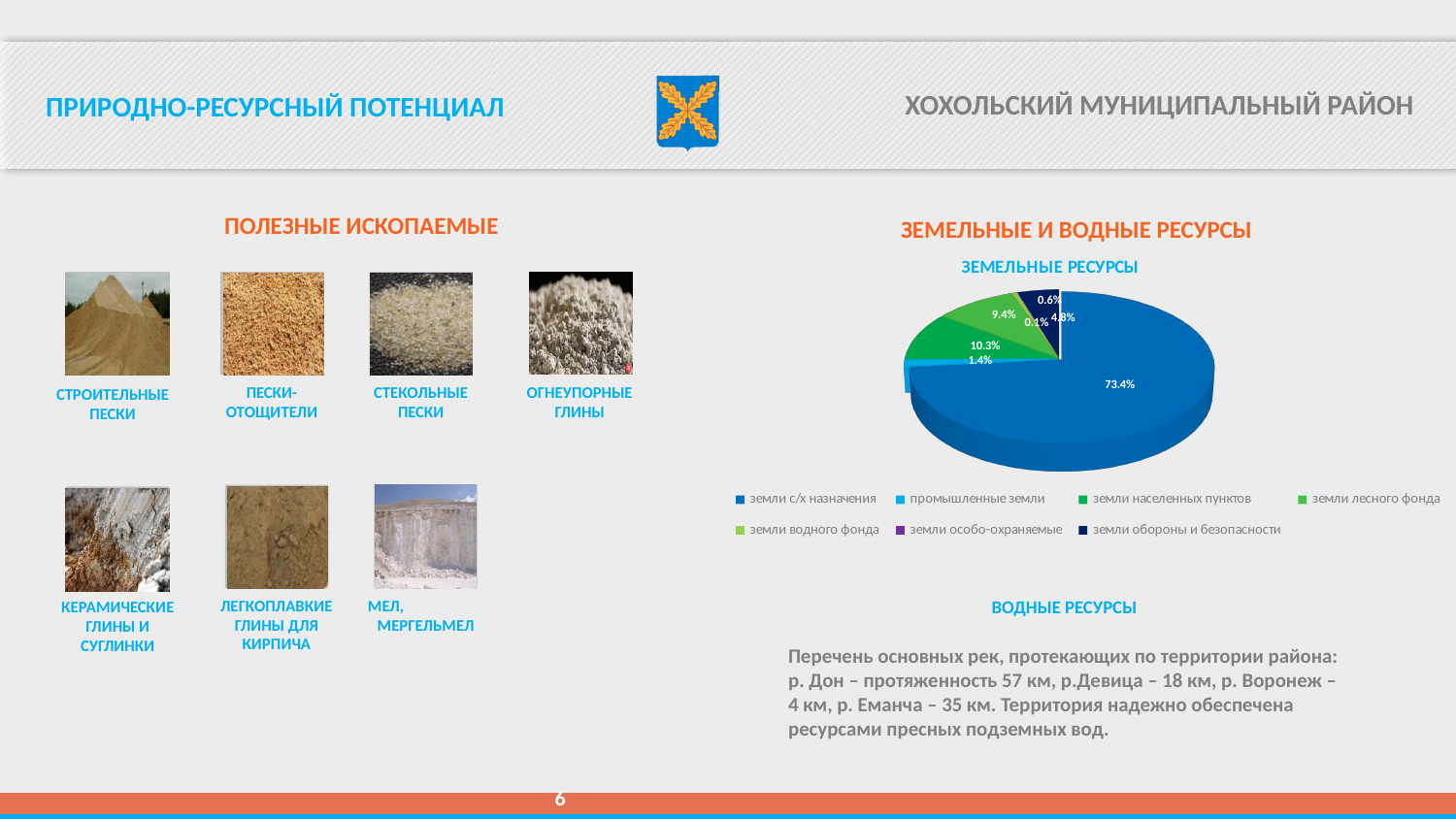
What is the smallest percentage label shown on the ЗЕМЕЛЬНЫЕ РЕСУРСЫ pie chart? 0.1% In the ЗЕМЕЛЬНЫЕ РЕСУРСЫ pie chart, what share is shown for промышленные земли? 1.4% What is the title of the pie chart on the slide? ЗЕМЕЛЬНЫЕ РЕСУРСЫ In the ЗЕМЕЛЬНЫЕ РЕСУРСЫ pie chart, what share is shown for земли обороны и безопасности? 4.8% What kind of chart is shown under the heading ЗЕМЕЛЬНЫЕ РЕСУРСЫ? Pie chart Which category has the largest slice in the ЗЕМЕЛЬНЫЕ РЕСУРСЫ pie chart? земли с/х назначения In the ЗЕМЕЛЬНЫЕ РЕСУРСЫ pie chart, which is larger: земли населенных пунктов or земли лесного фонда? земли населенных пунктов In the ЗЕМЕЛЬНЫЕ РЕСУРСЫ pie chart, what share is shown for земли населенных пунктов? 10.3% How many land categories does the legend of the ЗЕМЕЛЬНЫЕ РЕСУРСЫ pie chart list? 7 In the ЗЕМЕЛЬНЫЕ РЕСУРСЫ pie chart, what share is shown for земли с/х назначения? 73.4% In the ЗЕМЕЛЬНЫЕ РЕСУРСЫ pie chart, what share is shown for земли лесного фонда? 9.4% In the ЗЕМЕЛЬНЫЕ РЕСУРСЫ pie chart, by how many percentage points does земли населенных пунктов exceed земли лесного фонда? 0.9 percentage points